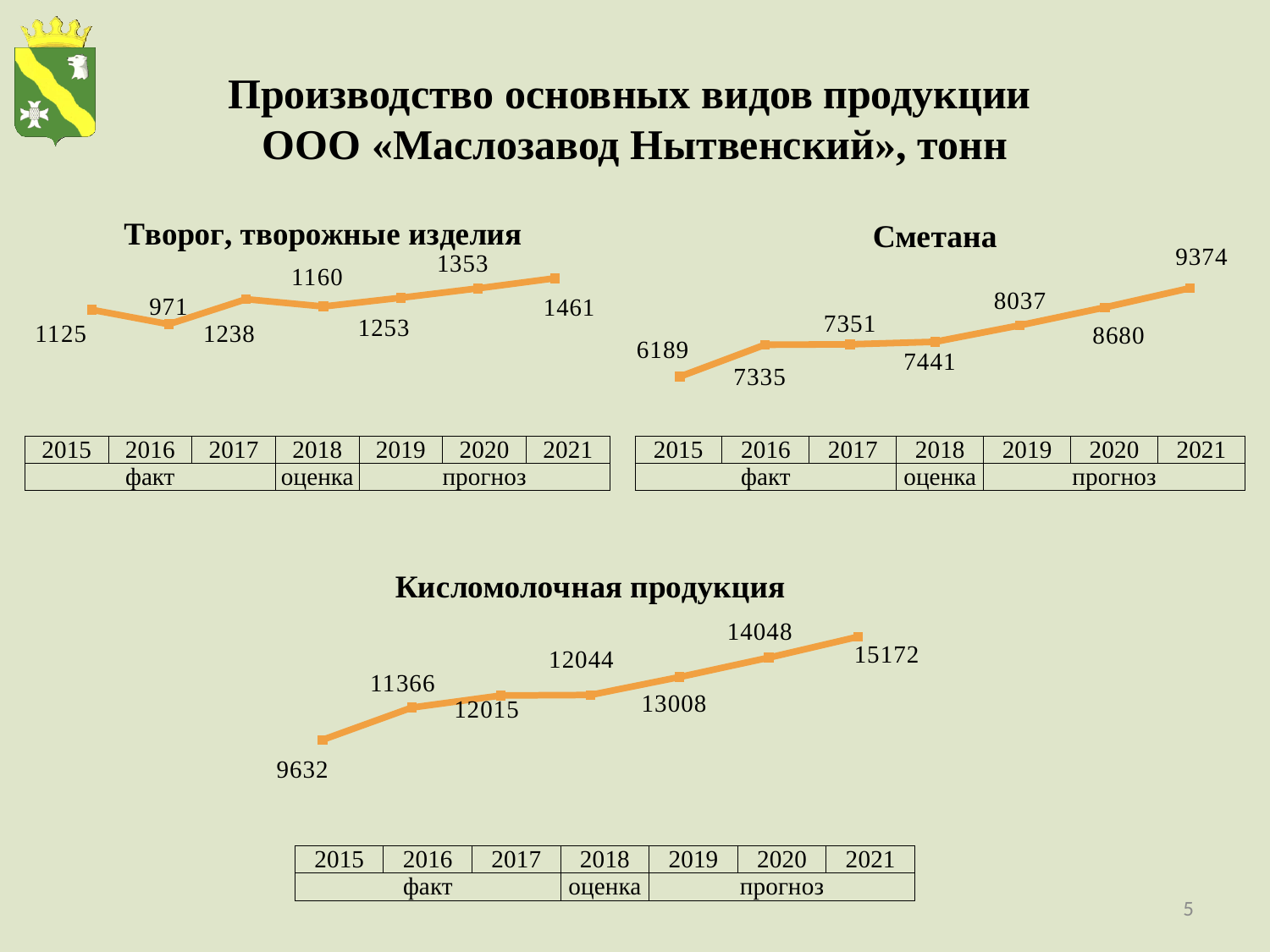
In the 'Сметана' chart, which year has the highest value? 2021 In the 'Сметана' chart, what is the difference between the 2016 and 2015 values? 1146 In the 'Кисломолочная продукция' chart, what is the value for 2018? 12044 In the 'Сметана' chart, what is the value for 2019? 8037 In the 'Творог, творожные изделия' chart, which year has the lowest value? 2016 How many data points are plotted in the 'Сметана' chart? 7 In the 'Творог, творожные изделия' chart, what is the value for 2015? 1125 What type of chart is the 'Кисломолочная продукция' chart? Line chart How many charts are shown on the slide? 3 In the 'Кисломолочная продукция' chart, is the value for 2020 larger than the value for 2019? Yes In the 'Кисломолочная продукция' chart, do the values rise or fall from 2015 to 2021? Rise In the 'Творог, творожные изделия' chart, what is the difference between the 2021 and 2020 values? 108